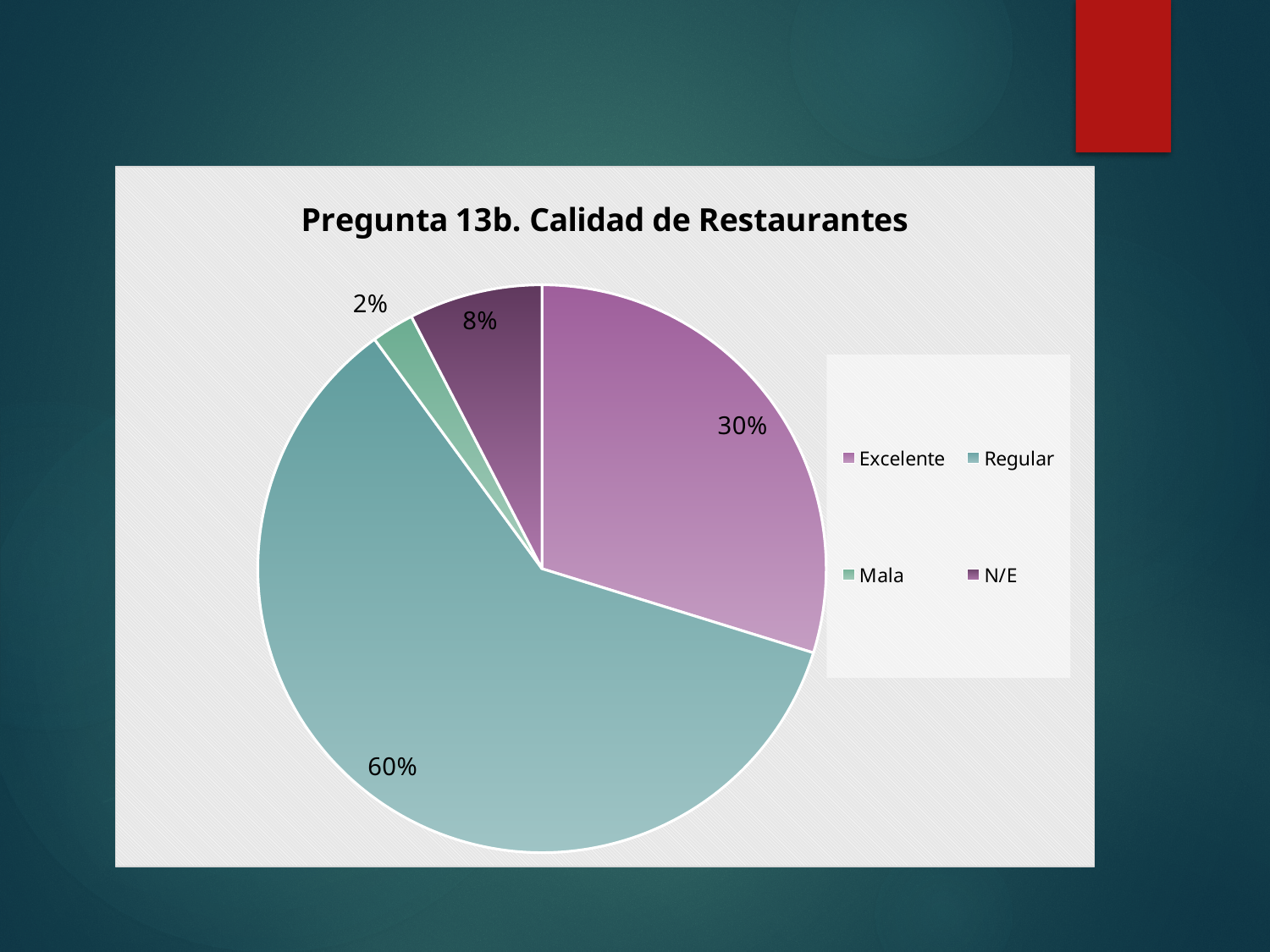
What kind of chart is shown on the slide? pie chart What share of the pie does N/E represent? 8% What is the title of the chart? Pregunta 13b. Calidad de Restaurantes Which category has the smallest slice of the pie? Mala What is the difference between the Regular and Excelente shares? 30% What share of the pie does Excelente represent? 30% How many categories does the pie chart show? 4 What share of the pie does Mala represent? 2% What is the difference between the N/E and Mala shares? 6% Which category has the largest slice of the pie? Regular Which is larger, the N/E slice or the Mala slice? N/E